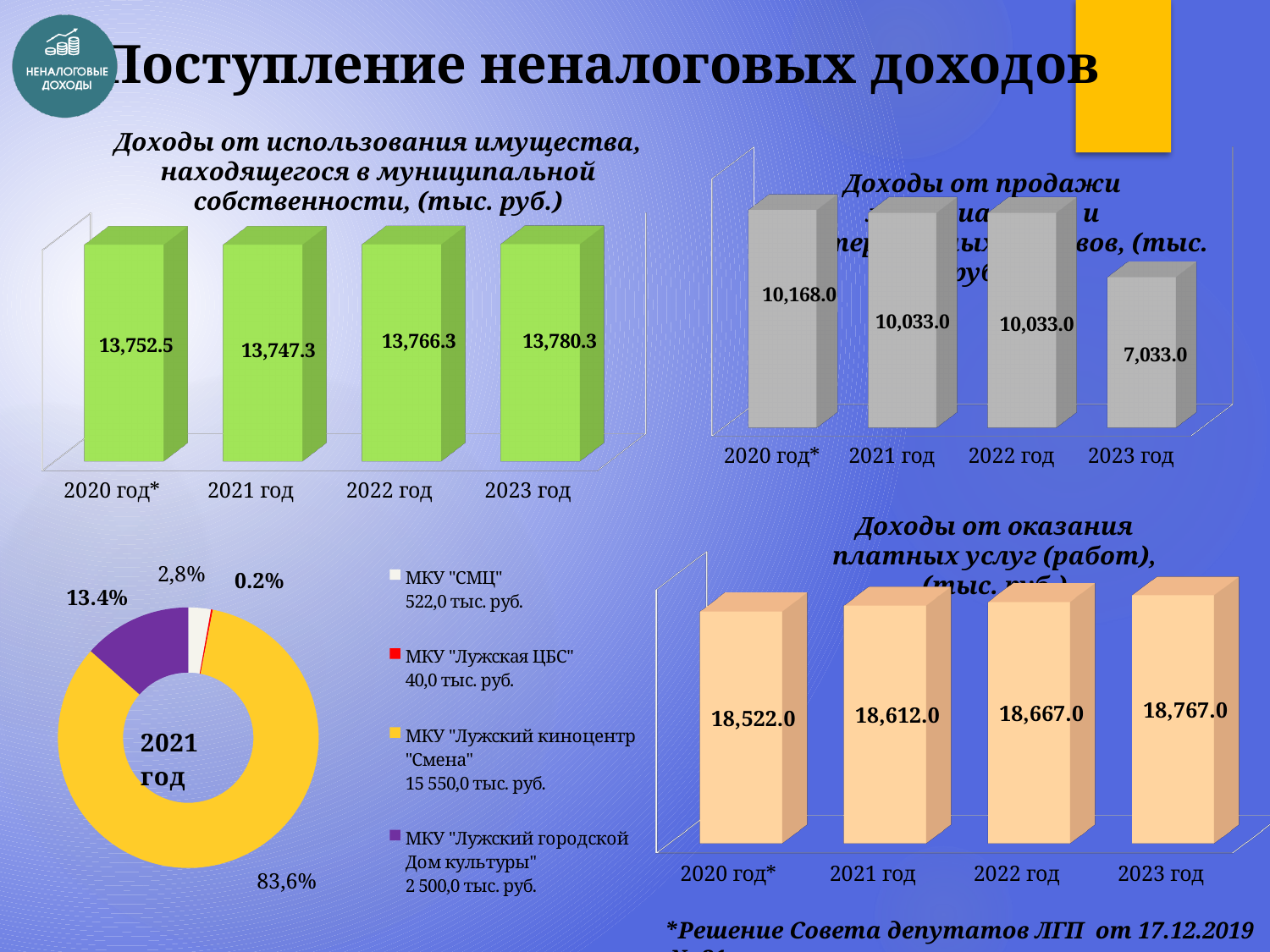
In the top-left chart (Доходы от использования имущества), what is the difference between the 2023 год and 2020 год* values? 27.8 In the bottom-right chart (Доходы от оказания платных услуг), how many years are shown? 4 In the bottom-right chart (Доходы от оказания платных услуг), what is the value for 2021 год? 18,612.0 In the bottom-right chart (Доходы от оказания платных услуг), do the values rise or fall from 2020 год* to 2023 год? rise In the top-right gray bar chart (Доходы от продажи), which year has the highest value? 2020 год* In the top-left chart (Доходы от использования имущества), what is the value for 2023 год? 13,780.3 In the bottom-left donut chart (2021 год), what amount is listed in the legend for МКУ "Лужская ЦБС"? 40,0 тыс. руб. In the top-right gray bar chart (Доходы от продажи), what is the value for 2023 год? 7,033.0 In the top-left chart (Доходы от использования имущества), which year has the lowest value? 2021 год What kind of chart is the bottom-left chart labelled 2021 год? donut (pie) chart In the bottom-left donut chart (2021 год), what share does МКУ "Лужский киноцентр "Смена" have? 83,6% In the top-right gray bar chart (Доходы от продажи), what is the difference between the 2022 год and 2023 год values? 3,000.0